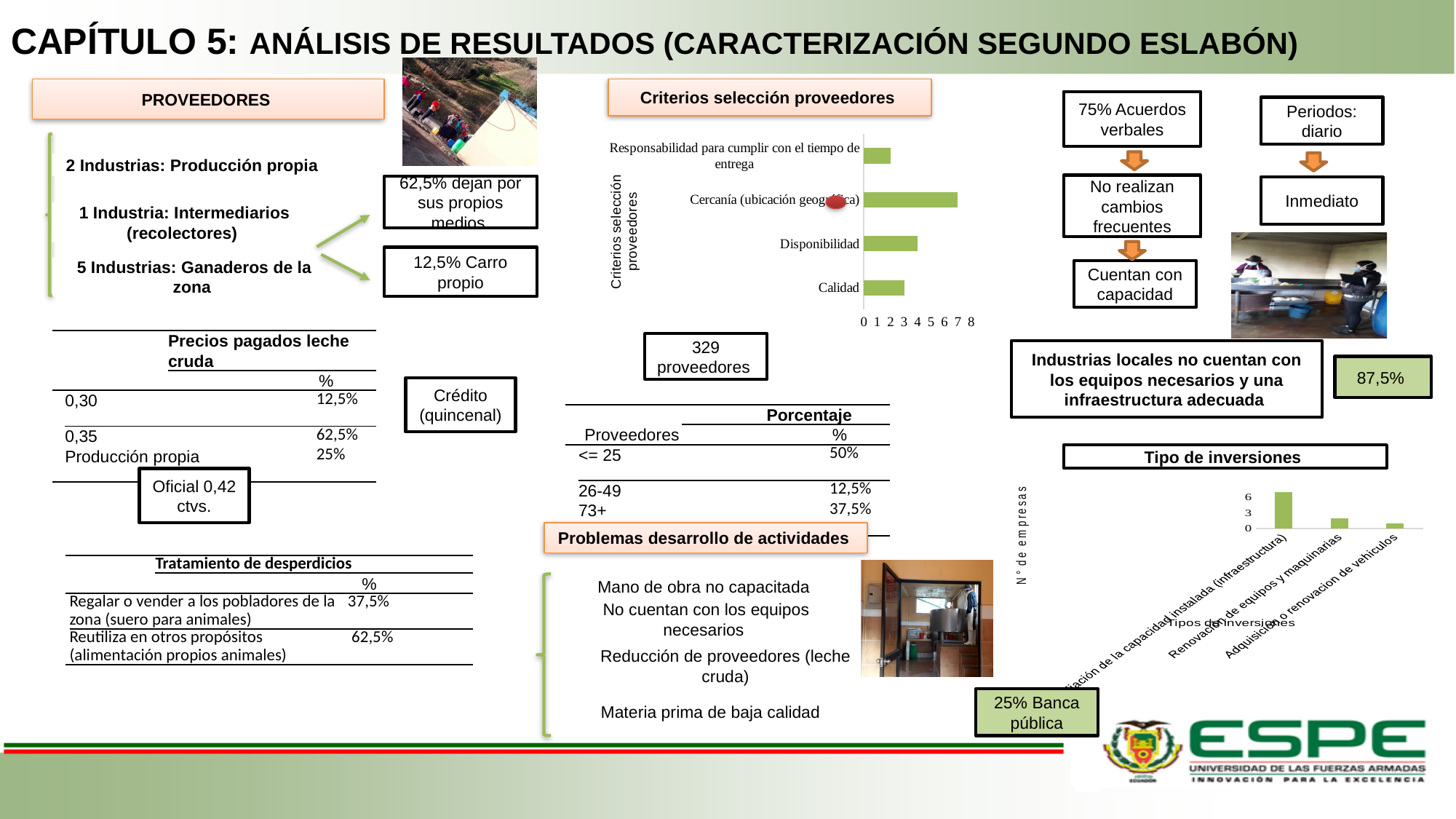
In the 'Criterios selección proveedores' chart, which is larger, Disponibilidad or Calidad? Disponibilidad In the 'Criterios selección proveedores' chart, how many criteria are plotted? 4 In the 'Criterios selección proveedores' chart, which criterion has the longest bar? Cercanía (ubicación geográfica) In the 'Criterios selección proveedores' chart, is the value for Calidad greater or less than 5? less In the 'Criterios selección proveedores' chart, is the value for Cercanía (ubicación geográfica) greater or less than 5? greater In the 'Tipo de inversiones' chart, what kind of chart is shown? bar chart In the 'Tipo de inversiones' chart, which investment type has the highest number of companies? Ampliación de la capacidad instalada (infraestructura) In the 'Tipo de inversiones' chart, is the value for Ampliación de la capacidad instalada (infraestructura) greater or less than 3? greater In the 'Tipo de inversiones' chart, what is the label of the vertical axis? N° de empresas In the 'Criterios selección proveedores' chart, which criterion has the shortest bar? Responsabilidad para cumplir con el tiempo de entrega In the 'Tipo de inversiones' chart, how many investment types are plotted? 3 In the 'Criterios selección proveedores' chart, what kind of chart is shown? bar chart